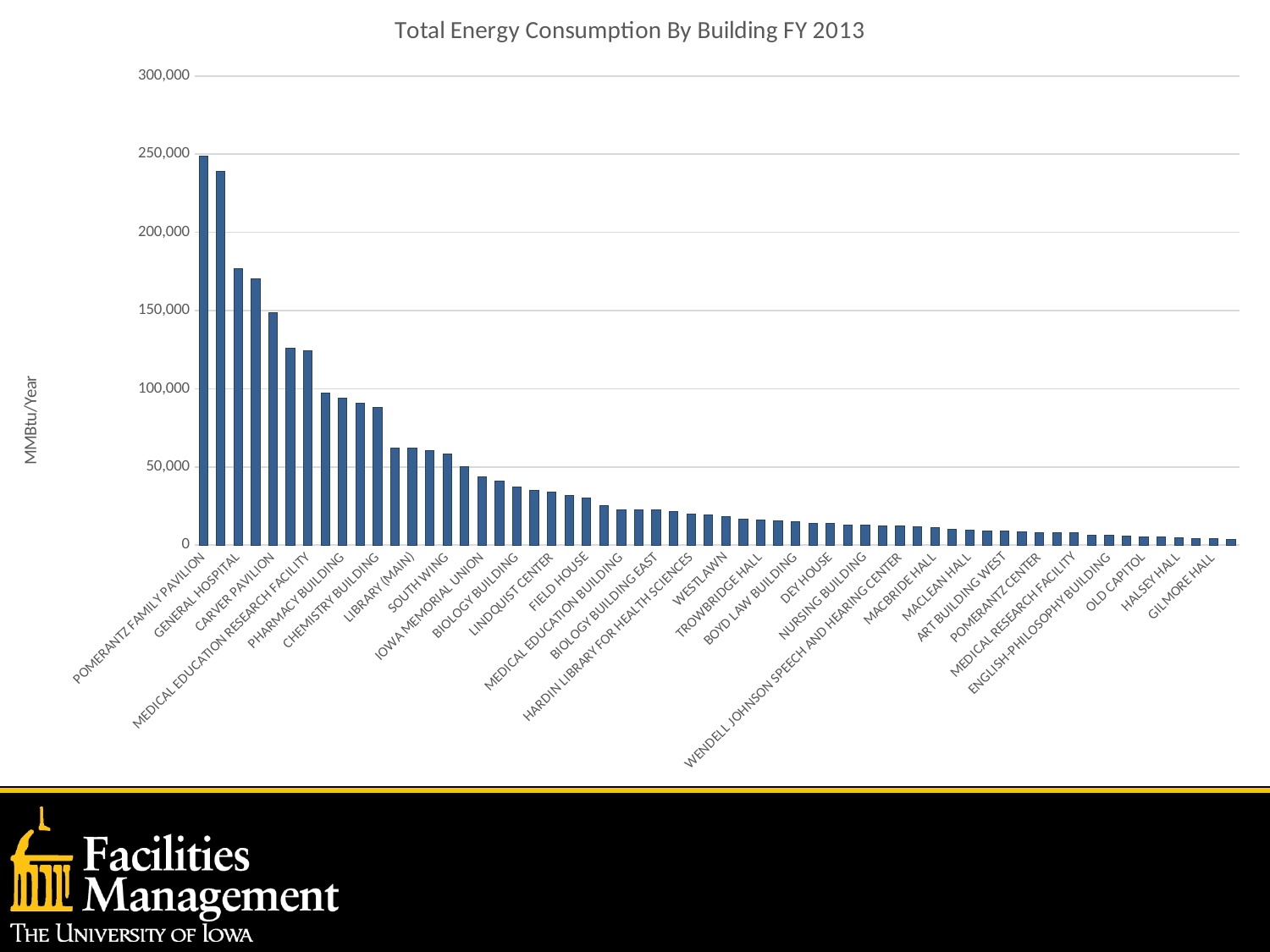
Is the value for Lindquist Center greater or less than 50,000? less Do the bar values rise or fall moving from left to right along the x axis? fall Is the value for Chemistry Building greater or less than 100,000? less Which building has the highest total energy consumption in the chart? Pomerantz Family Pavilion What kind of chart is shown on the slide? bar chart Which has the larger value, Field House or Library (Main)? Library (Main) What unit is shown on the vertical axis label of the chart? MMBtu/Year Which has the larger value, Carver Pavilion or Chemistry Building? Carver Pavilion Is the value for Library (Main) greater or less than 50,000? greater What is the title of the chart? Total Energy Consumption By Building FY 2013